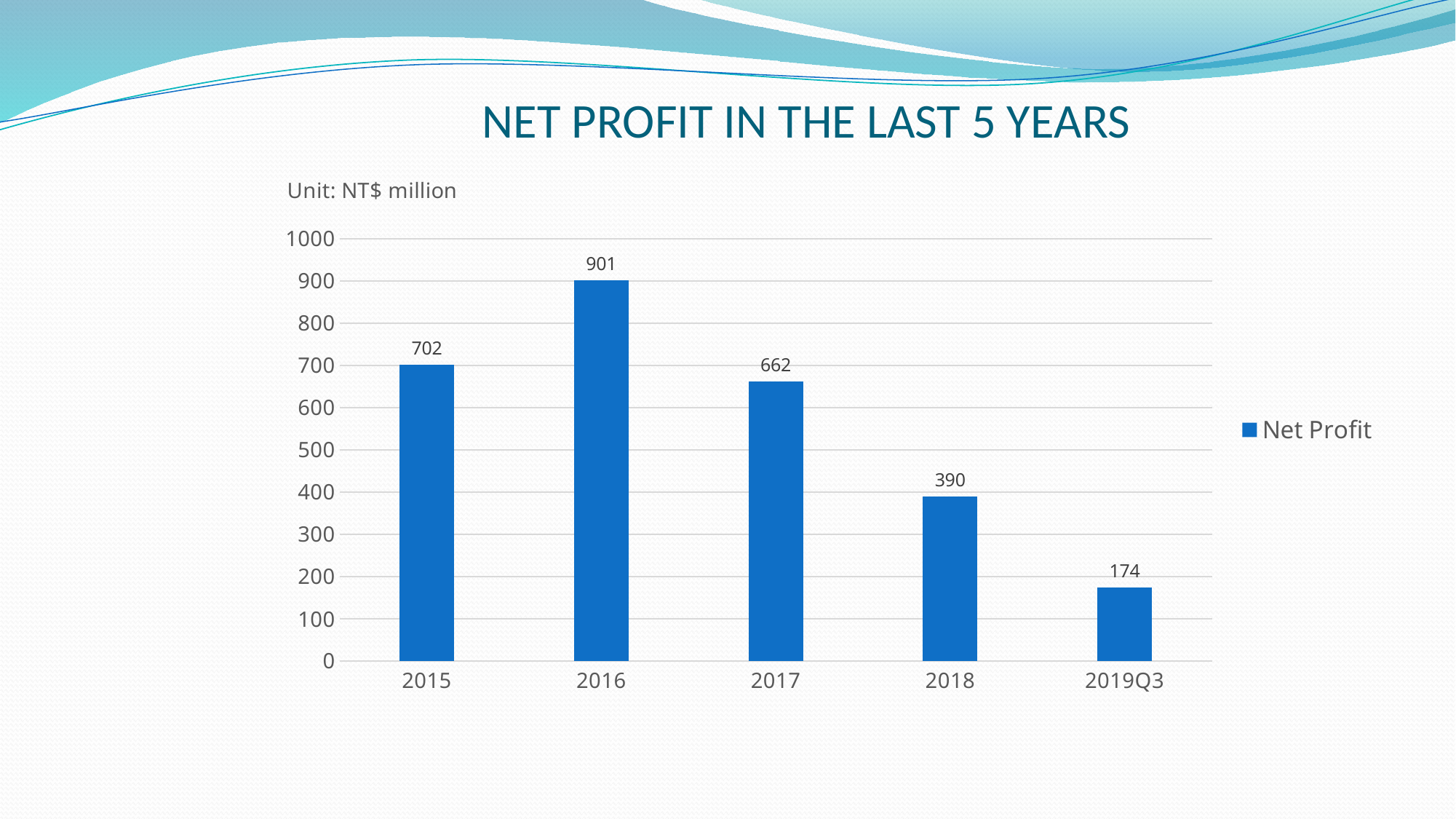
What kind of chart is shown on the slide? bar chart Which period has the lowest net profit? 2019Q3 What is the difference between the net profit in 2016 and 2017? 239 What unit is stated for the values in the chart? NT$ million Which year has the highest net profit? 2016 What is the difference between the net profit in 2015 and 2018? 312 How many series does the legend list? 1 What is the net profit for 2019Q3? 174 What is the net profit for 2016? 901 Which is larger, the net profit in 2015 or in 2017? 2015 How many periods are shown on the x axis? 5 What is the net profit for 2018? 390